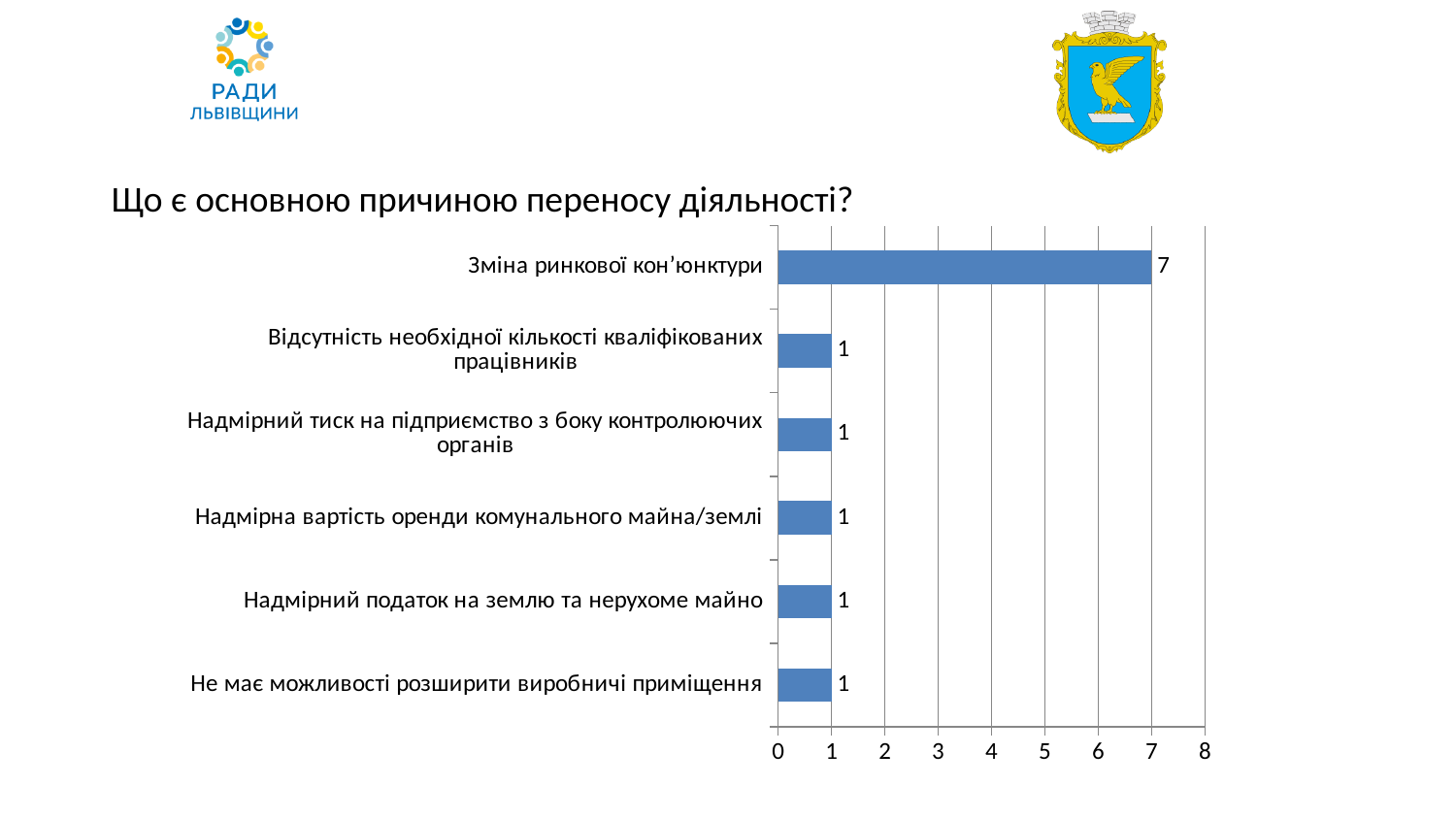
How many categories are shown in the chart? 6 What is the value for "Не має можливості розширити виробничі приміщення"? 1 Is the value for "Зміна ринкової кон’юнктури" greater or less than 5? greater Which category has the highest value? Зміна ринкової кон’юнктури What is the highest value shown on the x axis? 8 Which is larger: the value for "Зміна ринкової кон’юнктури" or the value for "Надмірний тиск на підприємство з боку контролюючих органів"? Зміна ринкової кон’юнктури What is the value for "Зміна ринкової кон’юнктури"? 7 What is the difference between the value for "Зміна ринкової кон’юнктури" and the value for "Надмірна вартість оренди комунального майна/землі"? 6 How many categories have a value of 1? 5 What is the title of the chart? Що є основною причиною переносу діяльності? What kind of chart is shown on the slide? bar chart What is the value for "Надмірний податок на землю та нерухоме майно"? 1